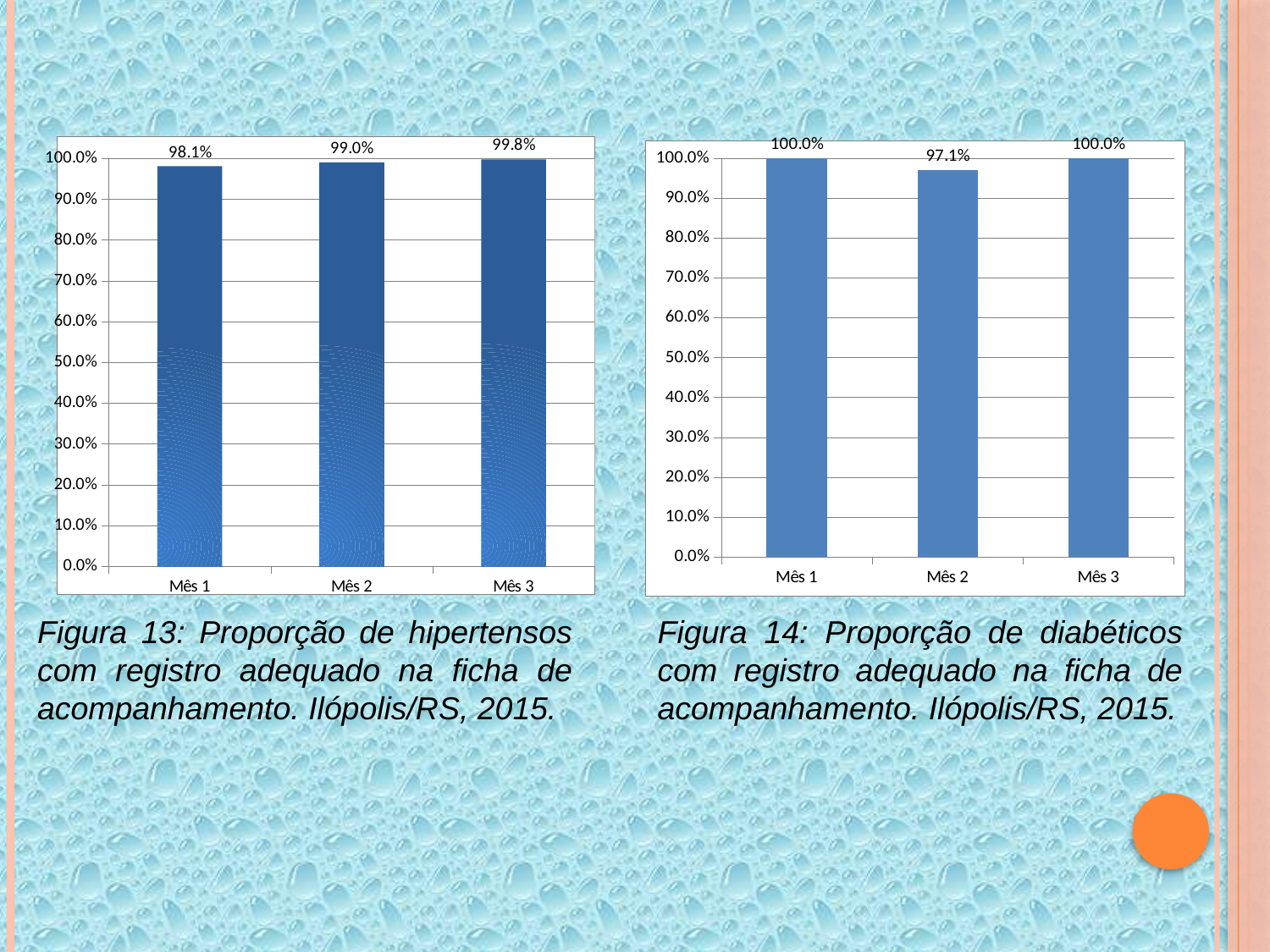
In the right chart (Figura 14, diabéticos), what is the value for Mês 1? 100.0% How many months are shown on the x axis of the right chart (Figura 14, diabéticos)? 3 In the right chart (Figura 14, diabéticos), which month has the lowest value? Mês 2 In the right chart (Figura 14, diabéticos), what is the difference between the values for Mês 1 and Mês 2? 2.9% In the left chart (Figura 13, hipertensos), what is the value for Mês 1? 98.1% Which is larger: the value for Mês 2 in the left chart (Figura 13) or the value for Mês 2 in the right chart (Figura 14)? Mês 2 in the left chart (Figura 13) In the left chart (Figura 13, hipertensos), do the values rise or fall from Mês 1 to Mês 3? rise In the right chart (Figura 14, diabéticos), what is the value for Mês 2? 97.1% What kind of chart is the left chart (Figura 13, hipertensos)? bar chart In the left chart (Figura 13, hipertensos), which month has the lowest value? Mês 1 In the left chart (Figura 13, hipertensos), what is the value for Mês 3? 99.8% In the left chart (Figura 13, hipertensos), what is the difference between the values for Mês 3 and Mês 1? 1.7%